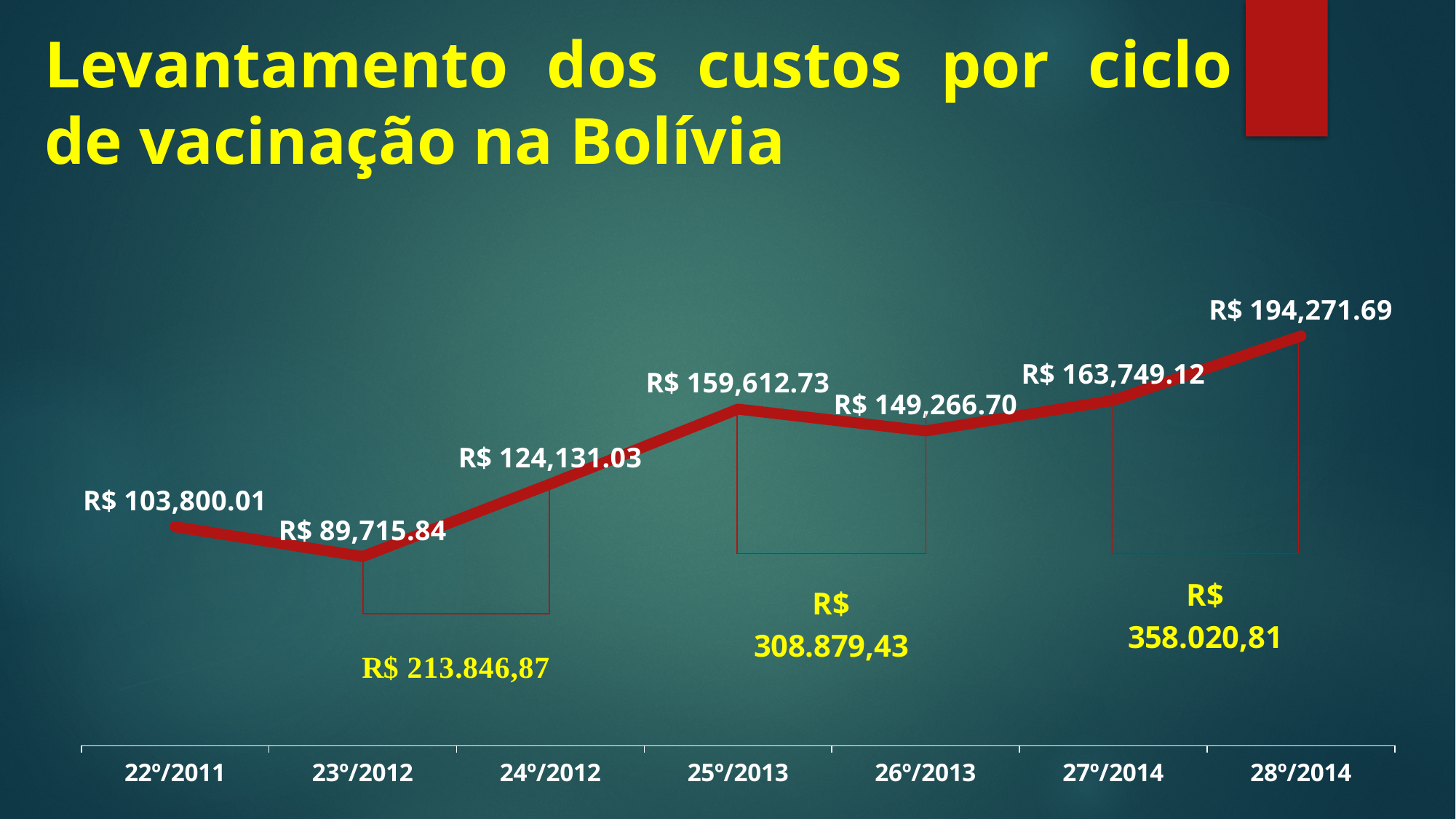
Which cycle has the highest cost? 28º/2014 What is the value for 28º/2014? R$ 194,271.69 What is the title of the chart? Levantamento dos custos por ciclo de vacinação na Bolívia Which cycle has the lowest cost? 23º/2012 How many cycles are plotted on the x axis? 7 What is the value for 22º/2011? R$ 103,800.01 What is the difference between the values for 25º/2013 and 26º/2013? R$ 10,346.03 Which is larger, the value for 24º/2012 or the value for 23º/2012? 24º/2012 What is the difference between the values for 28º/2014 and 22º/2011? R$ 90,471.68 Do the values generally rise or fall from 22º/2011 to 28º/2014? Rise What kind of chart is shown on the slide? Line chart What is the value for 26º/2013? R$ 149,266.70